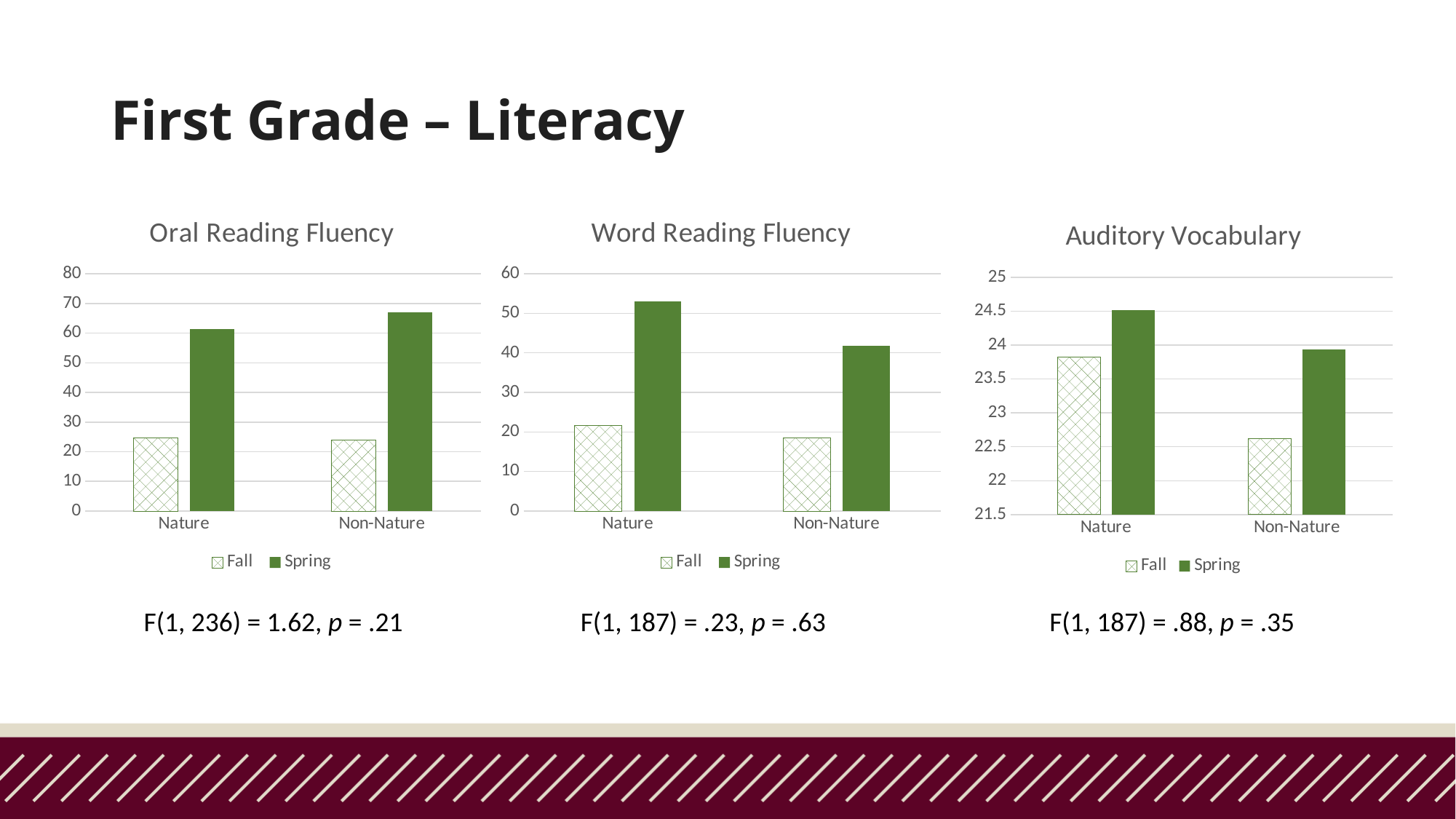
What kind of chart is the Auditory Vocabulary chart? bar chart In the Auditory Vocabulary chart, is the Spring value for Nature greater or less than 24? greater In the Auditory Vocabulary chart, is the Fall value for Non-Nature greater or less than 23? less How many series does the legend of the Word Reading Fluency chart list? 2 In the Word Reading Fluency chart, which group has the higher Spring value, Nature or Non-Nature? Nature In the Word Reading Fluency chart, is the Spring value for Nature greater or less than 50? greater How many categories are shown on the x axis of the Oral Reading Fluency chart? 2 In the Oral Reading Fluency chart, which group has the higher Spring value, Nature or Non-Nature? Non-Nature In the Auditory Vocabulary chart, which bar is the highest? Nature Spring In the Word Reading Fluency chart, which bar is the lowest? Non-Nature Fall